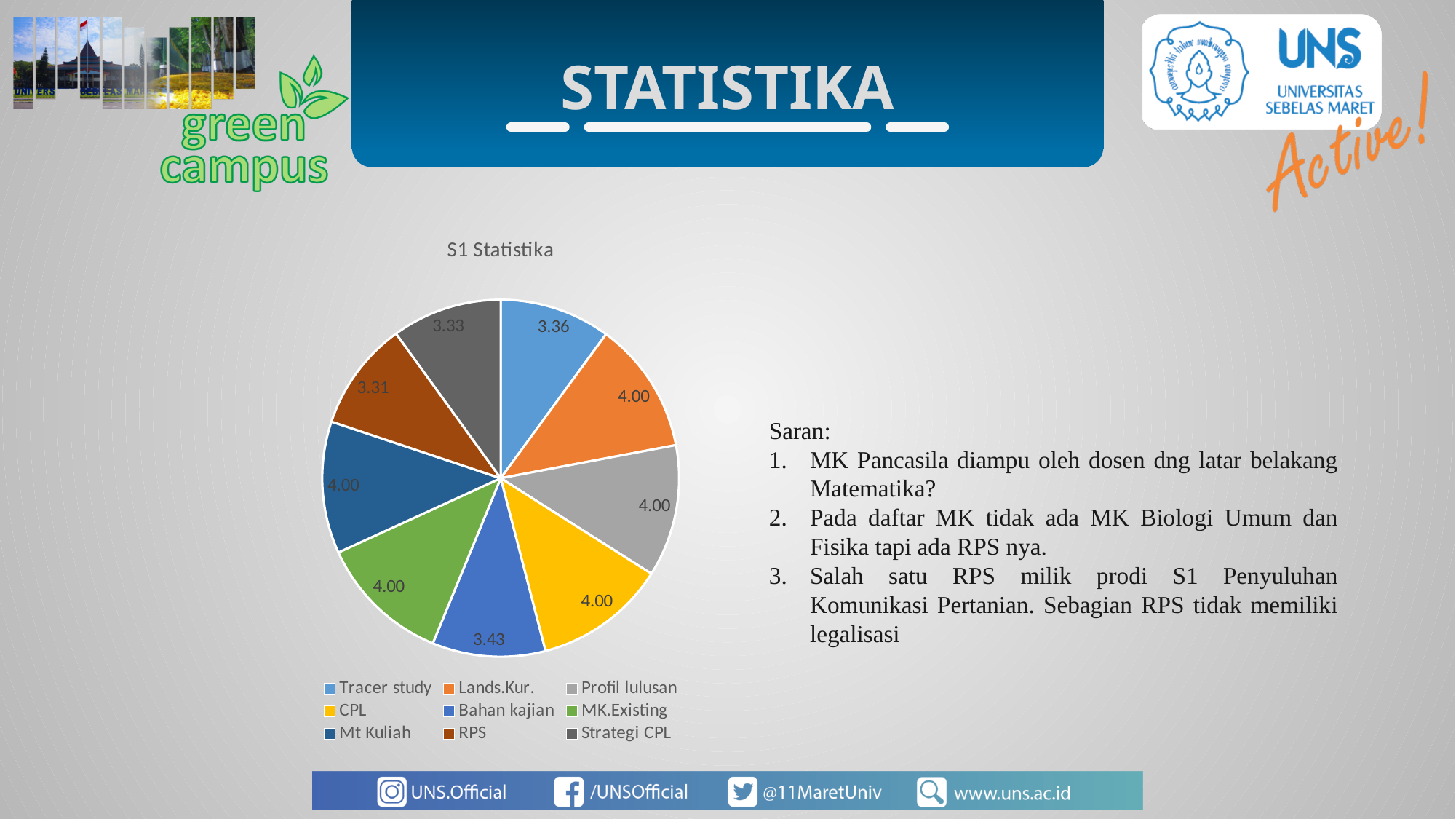
What is the value for Strategi CPL? 3.33 What is the value for RPS? 3.31 What type of chart is shown on the slide? pie chart How many slices does the pie chart have? 9 What colour is the slice for MK.Existing? green What is the value for Bahan kajian? 3.43 What is the difference between the value for Lands.Kur. and the value for Tracer study? 0.64 What is the title of the chart? S1 Statistika What is the value for Tracer study? 3.36 Which is larger, the value for Bahan kajian or the value for Tracer study? Bahan kajian Which category has the lowest value? RPS What is the value for Lands.Kur.? 4.00